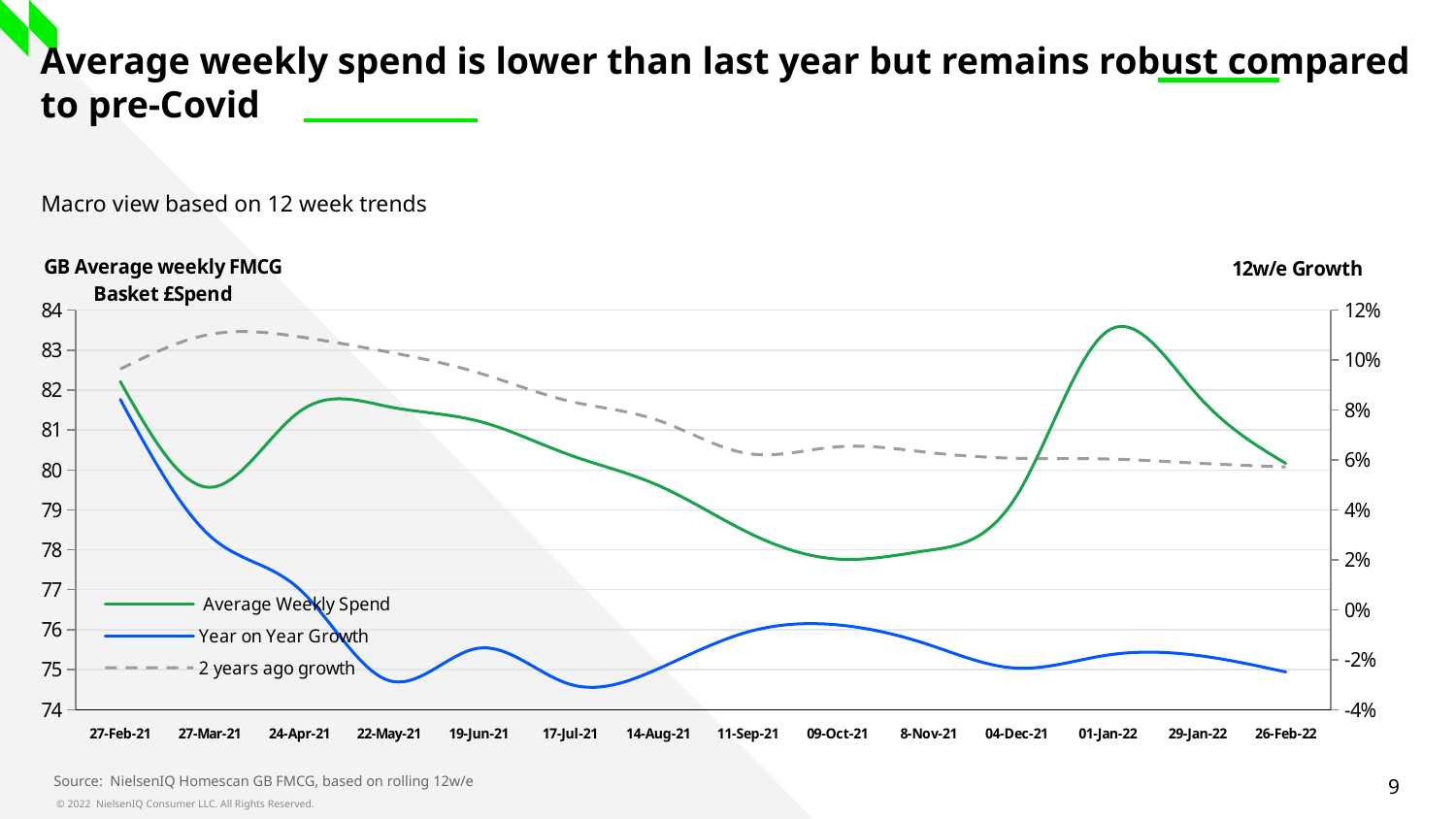
How many date labels are shown along the x axis of the chart? 14 Is the Average Weekly Spend value at 09-Oct-21 greater or less than 79? less What is the title of the right-hand axis of the chart? 12w/e Growth At which date does the Average Weekly Spend line reach its highest point? 01-Jan-22 At 26-Feb-22, which is higher: Year on Year Growth or 2 years ago growth? 2 years ago growth How many series does the chart legend list? 3 Is the Year on Year Growth value at 26-Feb-22 greater or less than 0%? less What kind of chart is shown on the slide? line chart Does the Year on Year Growth line rise or fall between 27-Feb-21 and 22-May-21? fall At which date does the Average Weekly Spend line reach its lowest point? 09-Oct-21 Which series is drawn as a dashed grey line? 2 years ago growth Is the Average Weekly Spend value at 01-Jan-22 greater or less than 83? greater